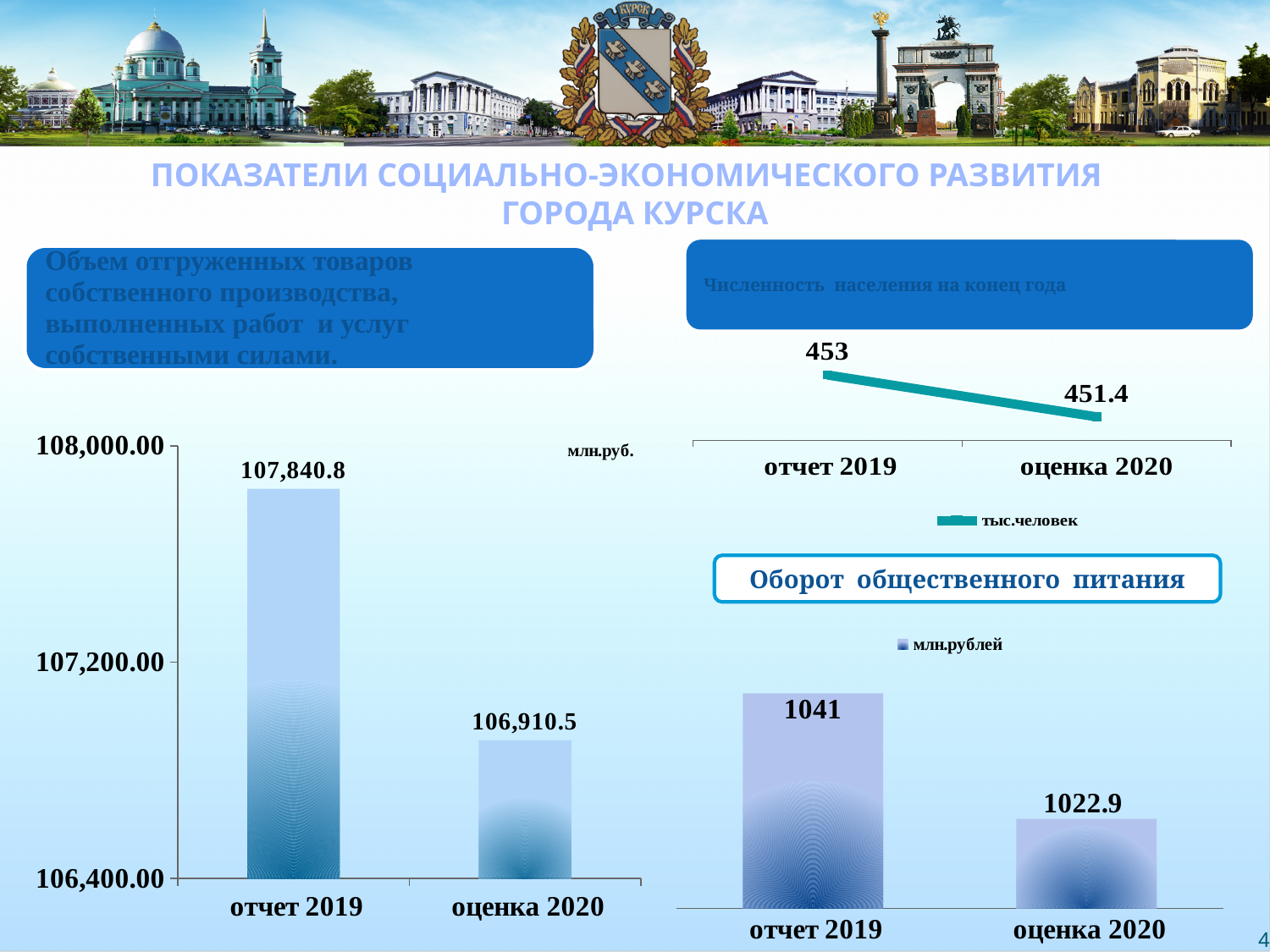
On the top-right chart (Численность населения на конец года), what kind of chart is shown? line chart On the left chart (Объем отгруженных товаров), what kind of chart is shown? bar chart On the top-right chart (Численность населения на конец года), what is the value for оценка 2020? 451.4 On the bottom-right chart (Оборот общественного питания), which category has the lowest value? оценка 2020 On the bottom-right chart (Оборот общественного питания), how many categories are shown? 2 On the left chart (Объем отгруженных товаров), what is the difference between отчет 2019 and оценка 2020? 930.3 On the left chart (Объем отгруженных товаров), do the values rise or fall from отчет 2019 to оценка 2020? fall On the left chart (Объем отгруженных товаров), what is the value for отчет 2019? 107,840.8 On the bottom-right chart (Оборот общественного питания), what is the value for отчет 2019? 1041 On the top-right chart (Численность населения на конец года), what is the value for отчет 2019? 453 On the left chart (Объем отгруженных товаров), what is the value for оценка 2020? 106,910.5 On the top-right chart (Численность населения на конец года), what unit does the legend show? тыс.человек